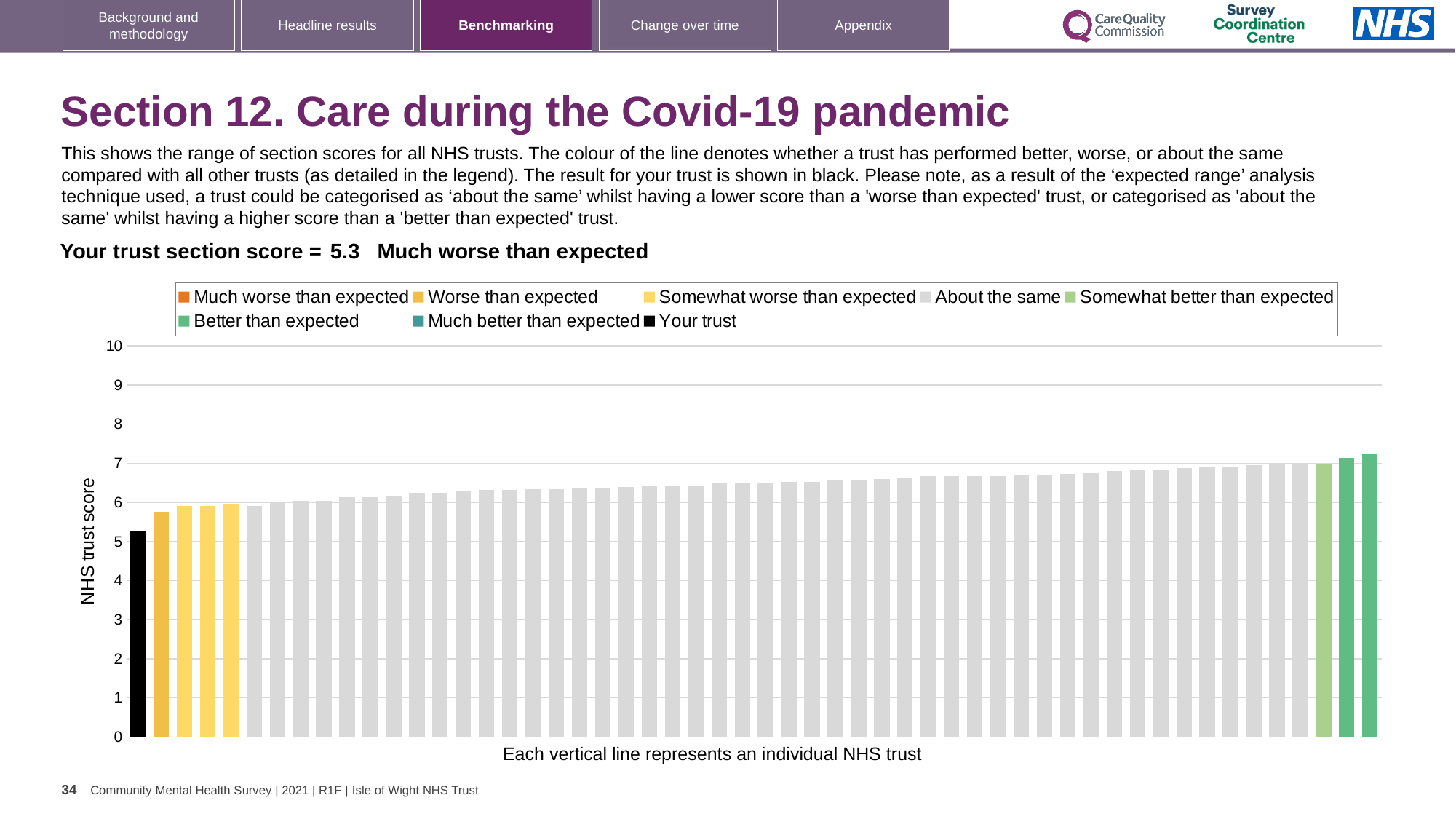
Is the value of the black 'Your trust' bar greater or less than 6? less How many green bars are there at the right end of the chart? 3 Is the value of the tallest bar greater or less than 8? less Which bar has the lowest value in the chart? Your trust (the black bar) Which performance category is your trust's section score assigned to? Much worse than expected What kind of chart is shown on the slide? bar chart What is the title of the vertical axis? NHS trust score What is the section score for your trust shown on the slide? 5.3 What colour is the bar representing your trust? black Is the value of the black 'Your trust' bar greater or less than 5? greater How many entries does the chart legend list? 8 Do the bar values rise or fall from left to right along the x axis? rise